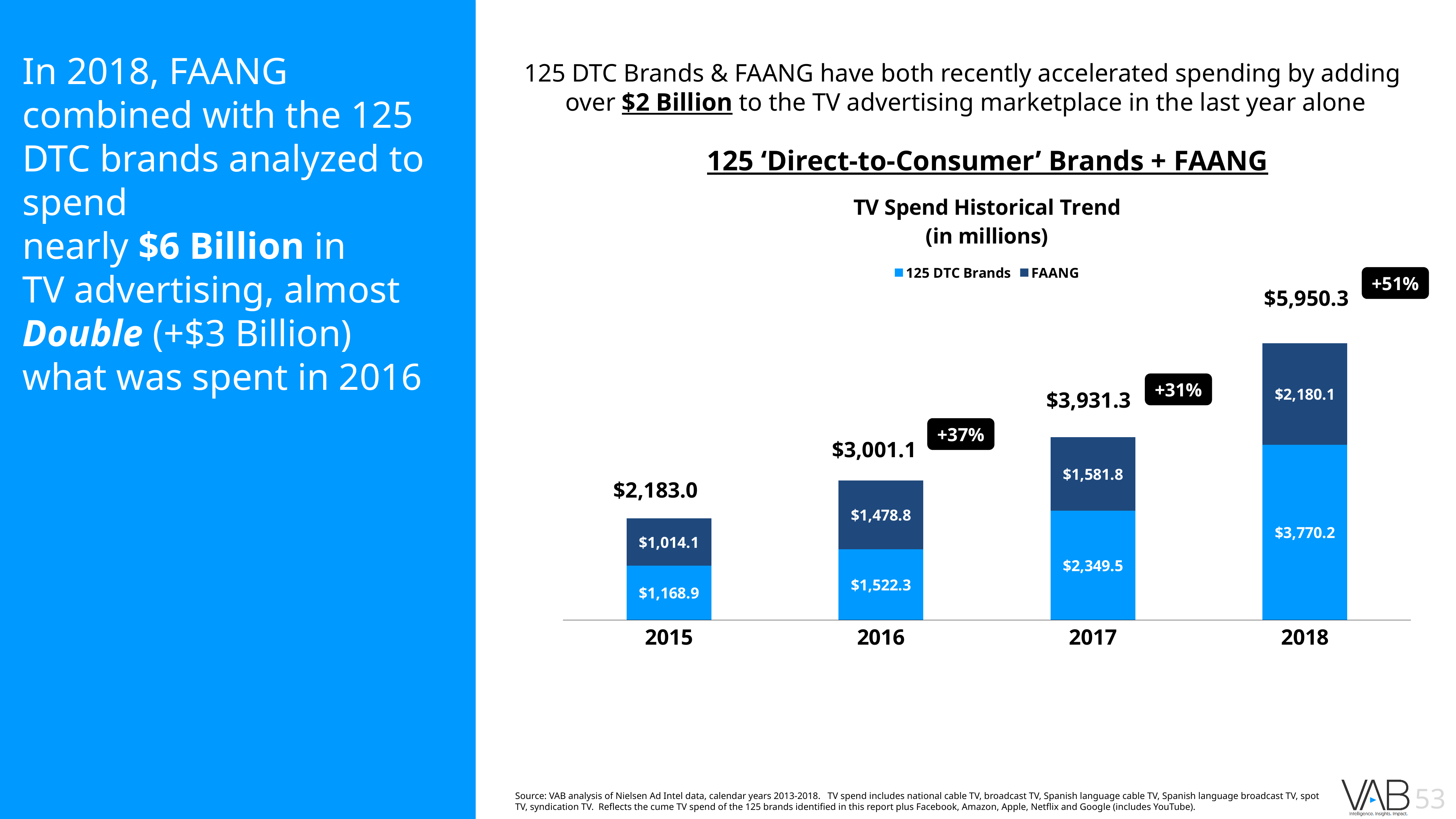
What is the TV spend for 125 DTC Brands in 2015? $1,168.9 Do the combined TV spend totals rise or fall from 2015 to 2018? Rise How many years are shown on the x axis? 4 How many series does the legend list? 2 What kind of chart is shown? Stacked bar chart What is the FAANG TV spend in 2018? $2,180.1 In 2017, which spent more on TV: 125 DTC Brands or FAANG? 125 DTC Brands What is the FAANG TV spend in 2016? $1,478.8 By how much did FAANG TV spend increase from 2017 to 2018? $598.3 Which year has the highest combined TV spend? 2018 What is the total combined TV spend for 2016? $3,001.1 In which year is the FAANG TV spend the lowest? 2015